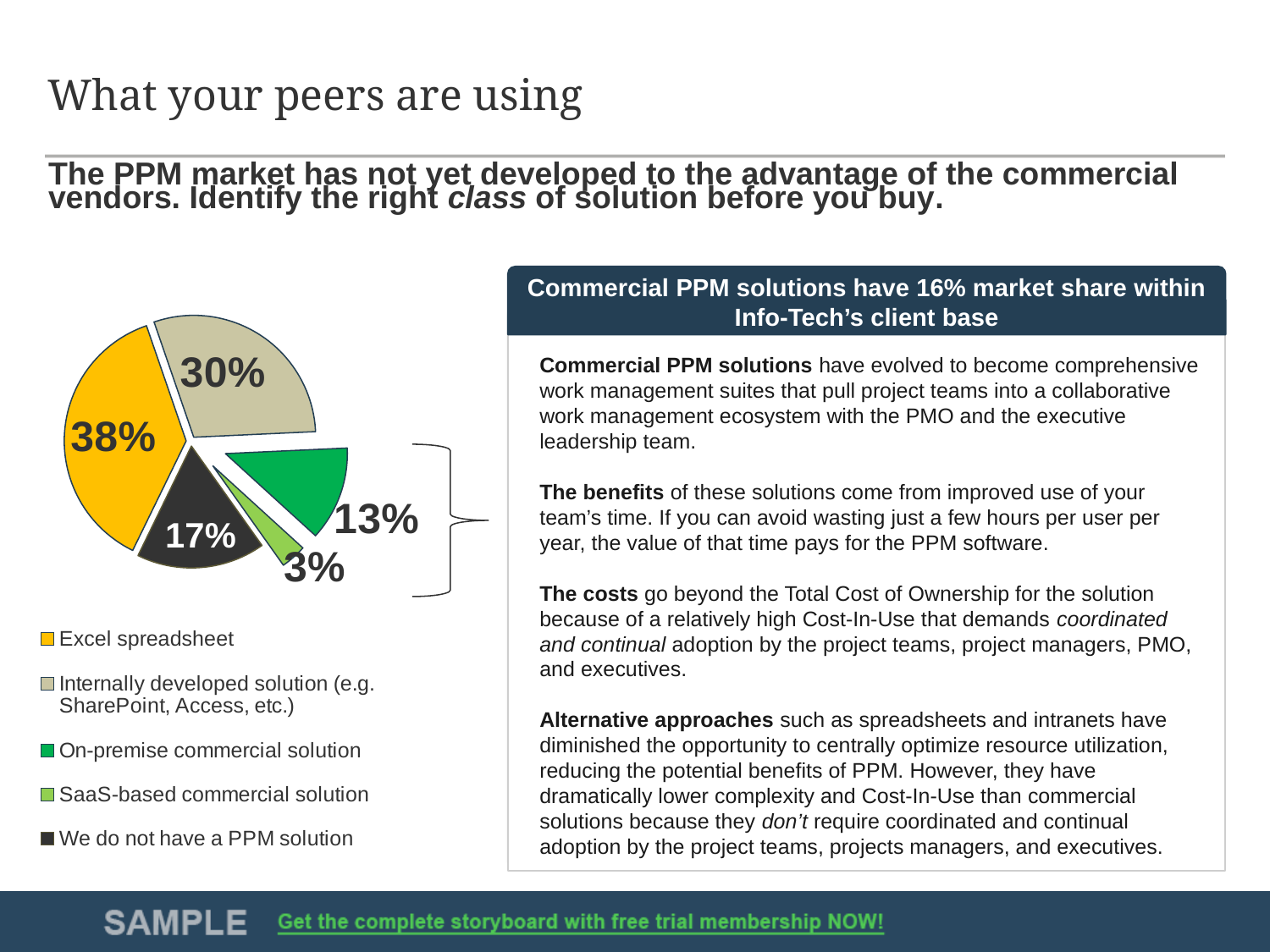
What percentage of the pie is On-premise commercial solution? 13% What percentage of the pie is We do not have a PPM solution? 17% Which category has the largest share of the pie? Excel spreadsheet Which is larger: the share for We do not have a PPM solution or the share for On-premise commercial solution? We do not have a PPM solution What percentage of the pie is Excel spreadsheet? 38% What percentage of the pie is SaaS-based commercial solution? 3% What percentage of the pie is Internally developed solution (e.g. SharePoint, Access, etc.)? 30% What kind of chart is shown on the slide? Pie chart What is the combined share of On-premise commercial solution and SaaS-based commercial solution? 16% What is the difference in percentage points between Excel spreadsheet and Internally developed solution? 8 How many categories does the pie chart have? 5 Which category has the smallest share of the pie? SaaS-based commercial solution